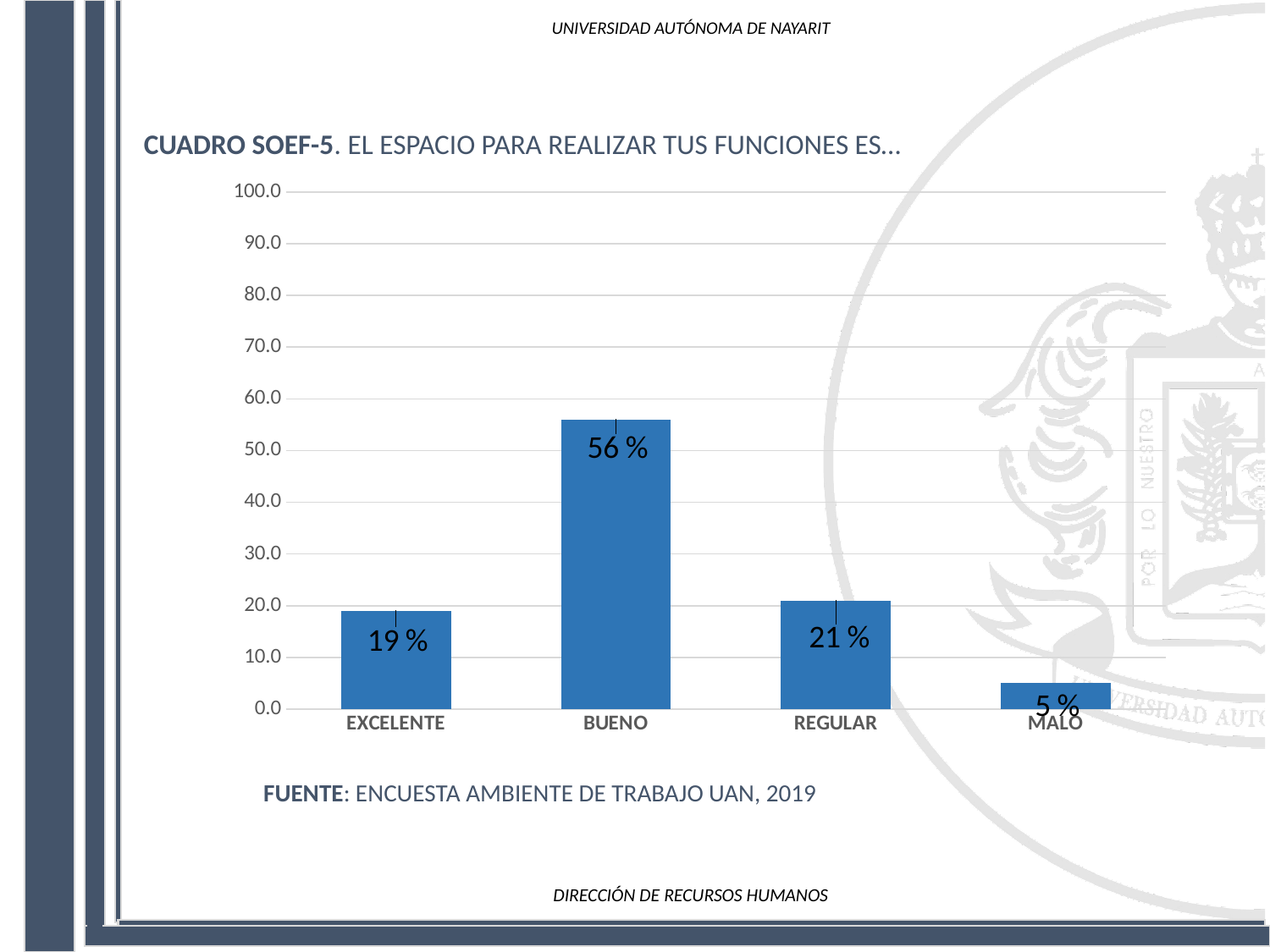
Which category has the highest value? BUENO What is the value for MALO? 5 % What is the difference between the values for REGULAR and EXCELENTE? 2 % What kind of chart is shown on the slide? bar chart Is the value for BUENO greater or less than 50.0? greater How many categories are shown on the x axis? 4 What is the value for EXCELENTE? 19 % What is the difference between the values for BUENO and REGULAR? 35 % What is the value for BUENO? 56 % Which category has the lowest value? MALO What is the value for REGULAR? 21 % Which is larger, the value for EXCELENTE or the value for MALO? EXCELENTE